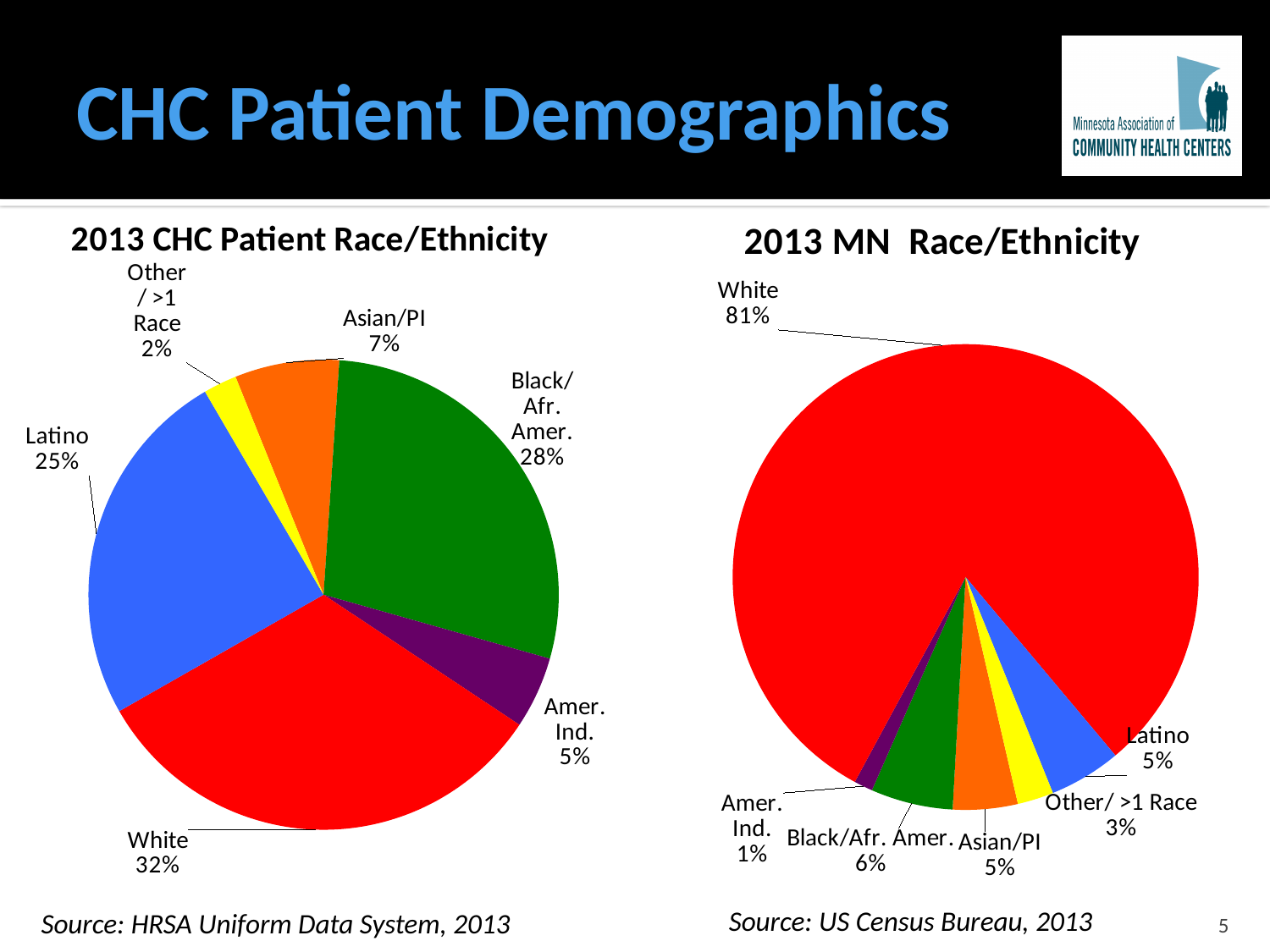
How many categories does the '2013 CHC Patient Race/Ethnicity' chart show? 6 In the '2013 MN Race/Ethnicity' chart, what share is Other/ >1 Race? 3% In the '2013 MN Race/Ethnicity' chart, which category has the smallest share? Amer. Ind. What kind of chart is the '2013 MN Race/Ethnicity' chart? Pie chart Which is larger in the '2013 CHC Patient Race/Ethnicity' chart: the Asian/PI share or the Amer. Ind. share? Asian/PI In the '2013 CHC Patient Race/Ethnicity' chart, which category has the smallest share? Other / >1 Race In the '2013 CHC Patient Race/Ethnicity' chart, what is the difference between the White share and the Black/Afr. Amer. share? 4% In the '2013 MN Race/Ethnicity' chart, what share is White? 81% In the '2013 CHC Patient Race/Ethnicity' chart, which category has the largest share? White In the '2013 CHC Patient Race/Ethnicity' chart, what share of patients is Latino? 25% In the '2013 MN Race/Ethnicity' chart, what is the difference between the White share and the Black/Afr. Amer. share? 75% What colour is the White slice in the '2013 CHC Patient Race/Ethnicity' chart? Red